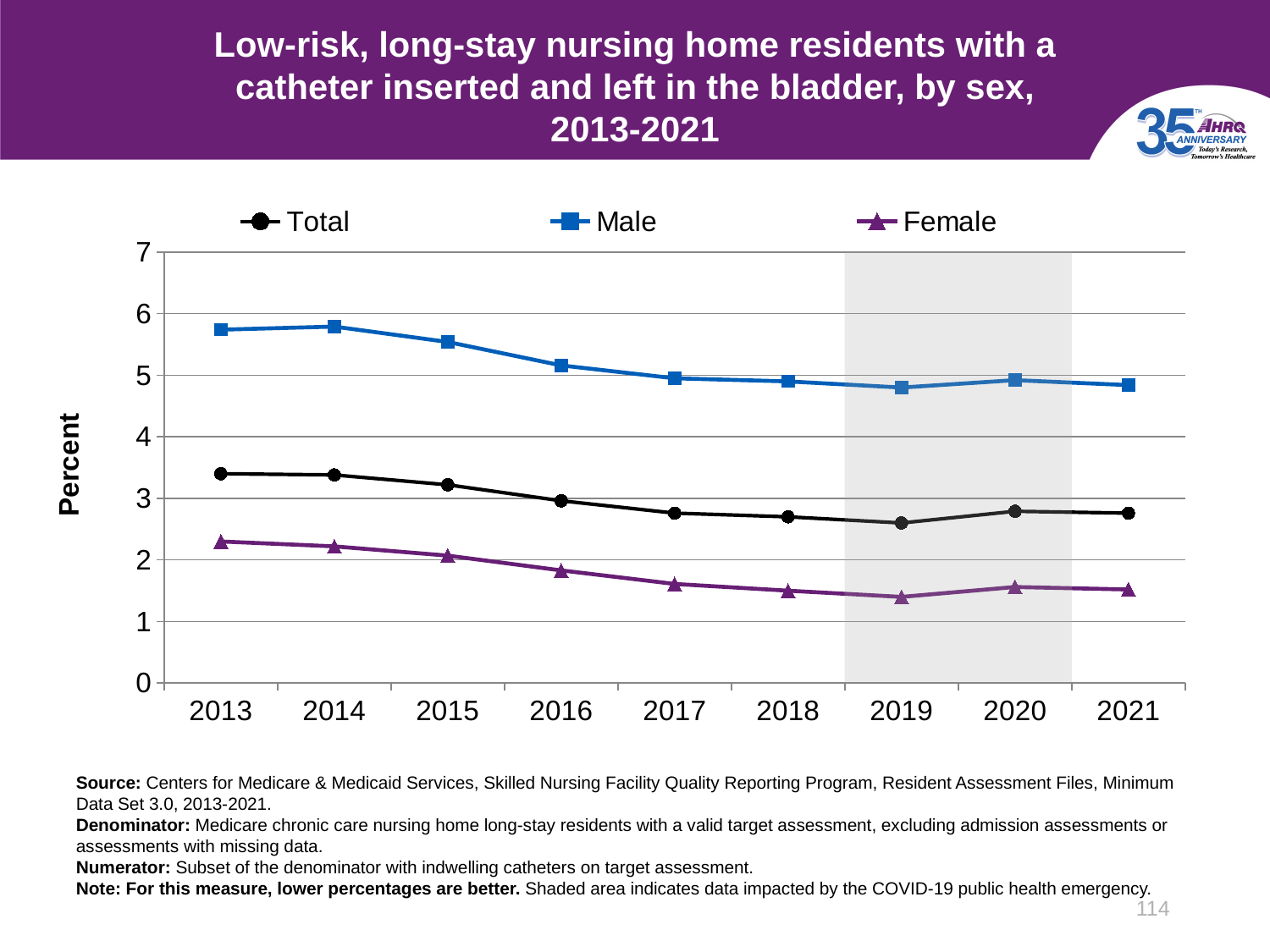
How many years are plotted along the x axis? 9 Which series has the lowest values across all years? Female Which series has the highest values across all years? Male What kind of chart is shown on the slide? line chart Is the value for Total in 2017 greater or less than 3? less Is the value for Female in 2019 greater or less than 2? less Is the value for Total in 2013 greater or less than 3? greater What is the label on the y axis? Percent How many series does the legend list? 3 Does the Male series rise or fall from 2014 to 2018? fall Which is larger in 2016, the value for Male or the value for Total? Male